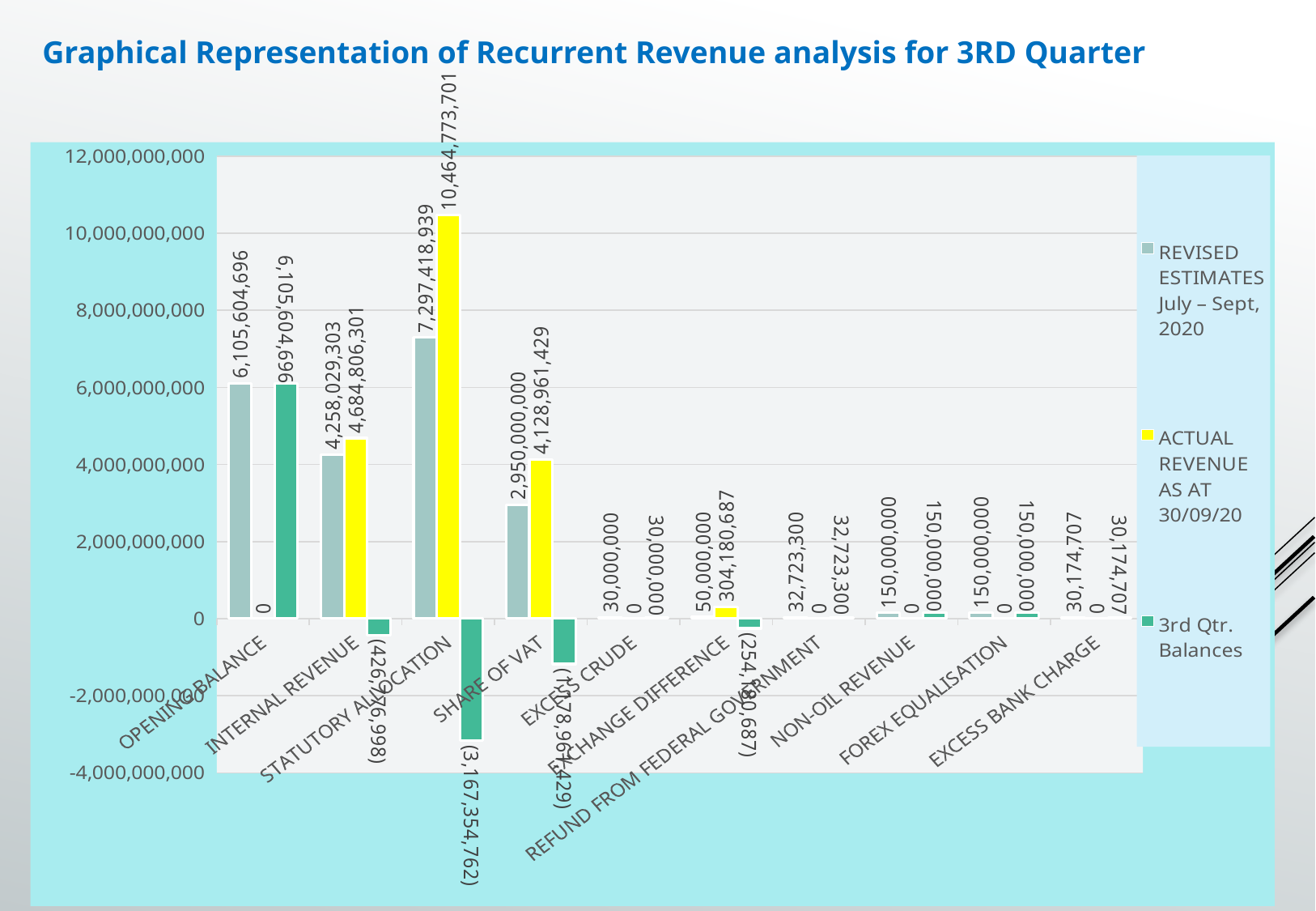
What colour represents the ACTUAL REVENUE AS AT 30/09/20 series? yellow What kind of chart is shown on the slide? bar chart How many categories are shown on the x axis? 10 Which category has the highest ACTUAL REVENUE AS AT 30/09/20? STATUTORY ALLOCATION What is the 3rd Qtr. Balances value for STATUTORY ALLOCATION? (3,167,354,762) How many series does the legend list? 3 What is the difference between the ACTUAL REVENUE and the REVISED ESTIMATES for SHARE OF VAT? 1,178,961,429 For INTERNAL REVENUE, which is larger: the REVISED ESTIMATES or the ACTUAL REVENUE AS AT 30/09/20? ACTUAL REVENUE AS AT 30/09/20 What is the REVISED ESTIMATES July – Sept, 2020 value for SHARE OF VAT? 2,950,000,000 What is the ACTUAL REVENUE AS AT 30/09/20 for STATUTORY ALLOCATION? 10,464,773,701 What is the ACTUAL REVENUE AS AT 30/09/20 for OPENING BALANCE? 0 What is the REVISED ESTIMATES July – Sept, 2020 value for EXCHANGE DIFFERENCE? 50,000,000